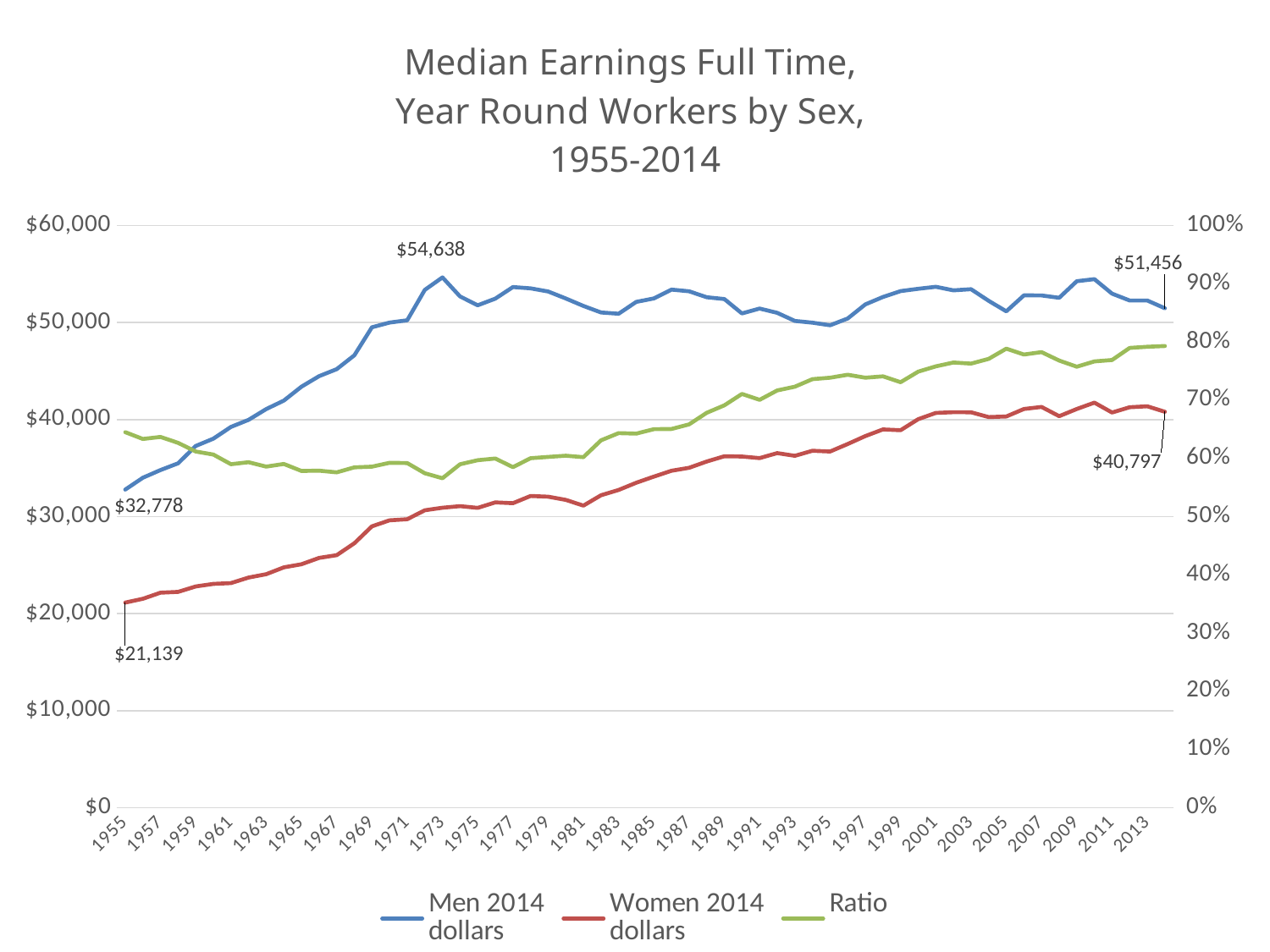
Do the Women 2014 dollars values generally rise or fall from 1955 to 2014? rise What was the median earnings for women (2014 dollars) in 1955? $21,139 What is the difference between men's and women's median earnings in 2014? $10,659 What is the difference between men's and women's median earnings in 1955? $11,639 What kind of chart is shown on the slide? line chart What was the median earnings for men (2014 dollars) in 2014? $51,456 What is the labeled peak value of the Men 2014 dollars series? $54,638 How many series does the legend list? 3 Is the Ratio value in 2013 greater or less than 70%? greater What was the median earnings for women (2014 dollars) in 2014? $40,797 Which series is higher in 2014, Men 2014 dollars or Women 2014 dollars? Men 2014 dollars What was the median earnings for men (2014 dollars) in 1955? $32,778